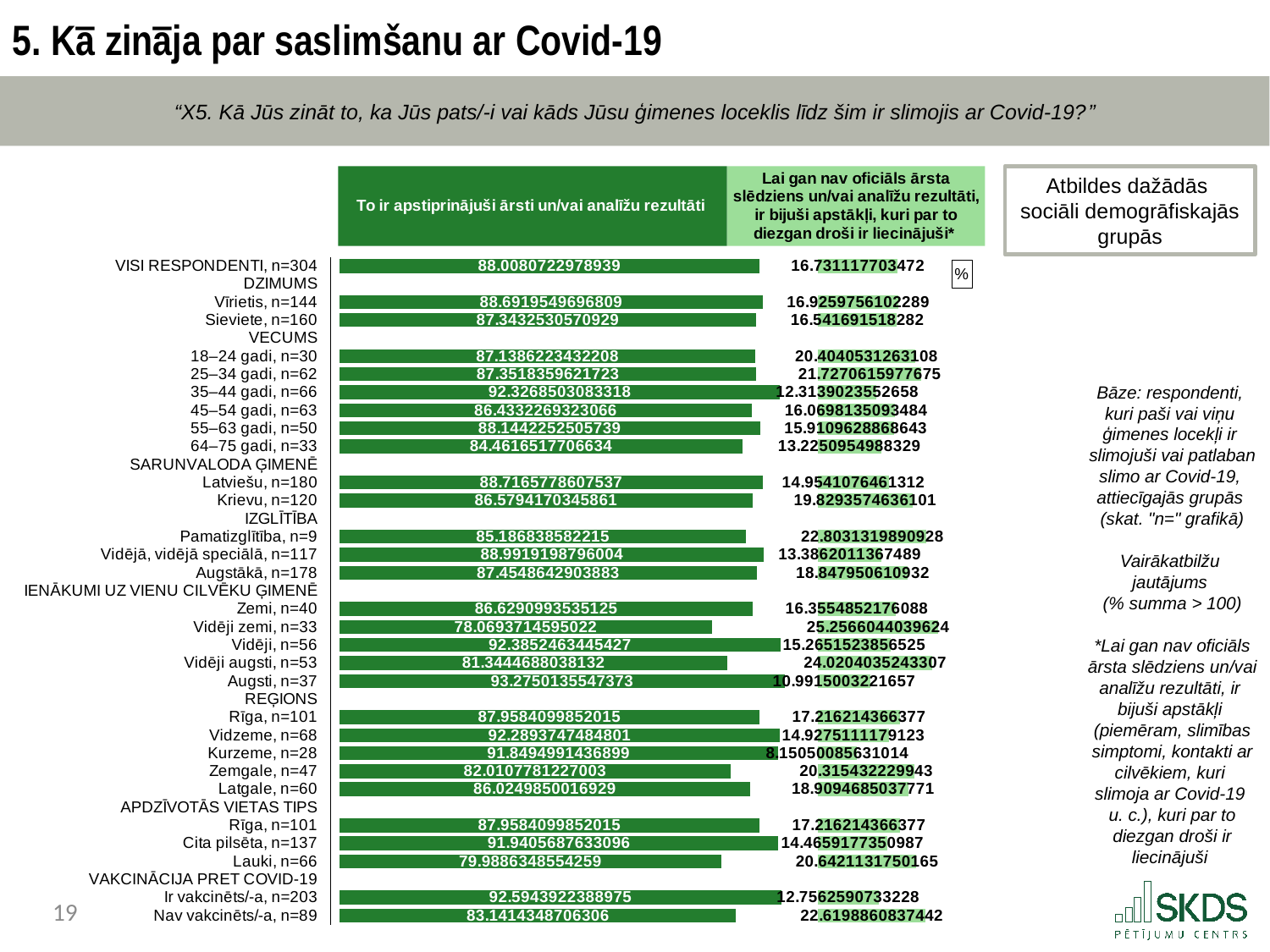
Which group has the lowest value for "To ir apstiprinājuši ārsti un/vai analīžu rezultāti"? Vidēji zemi, n=33 What is the value of "To ir apstiprinājuši ārsti un/vai analīžu rezultāti" for Ir vakcinēts/-a, n=203? 92.5943922388975 Which has the larger value for "To ir apstiprinājuši ārsti un/vai analīžu rezultāti": Rīga, n=101 or Latgale, n=60? Rīga, n=101 What is the value of "Lai gan nav oficiāls ārsta slēdziens un/vai analīžu rezultāti, ir bijuši apstākļi, kuri par to diezgan droši ir liecinājuši*" for Vidēji zemi, n=33? 25.2566044039624 What is the value of "To ir apstiprinājuši ārsti un/vai analīžu rezultāti" for Lauki, n=66? 79.9886348554259 Which has the larger value for "To ir apstiprinājuši ārsti un/vai analīžu rezultāti": Latviešu, n=180 or Krievu, n=120? Latviešu, n=180 What is the value of "Lai gan nav oficiāls ārsta slēdziens un/vai analīžu rezultāti, ir bijuši apstākļi, kuri par to diezgan droši ir liecinājuši*" for Kurzeme, n=28? 8.15050085631014 What is the value of "To ir apstiprinājuši ārsti un/vai analīžu rezultāti" for VISI RESPONDENTI, n=304? 88.0080722978939 Which group has the lowest value for "Lai gan nav oficiāls ārsta slēdziens un/vai analīžu rezultāti, ir bijuši apstākļi, kuri par to diezgan droši ir liecinājuši*"? Kurzeme, n=28 Which group has the highest value for "To ir apstiprinājuši ārsti un/vai analīžu rezultāti"? Augsti, n=37 What kind of chart is shown on the slide? Bar chart How many series does the chart show? 2